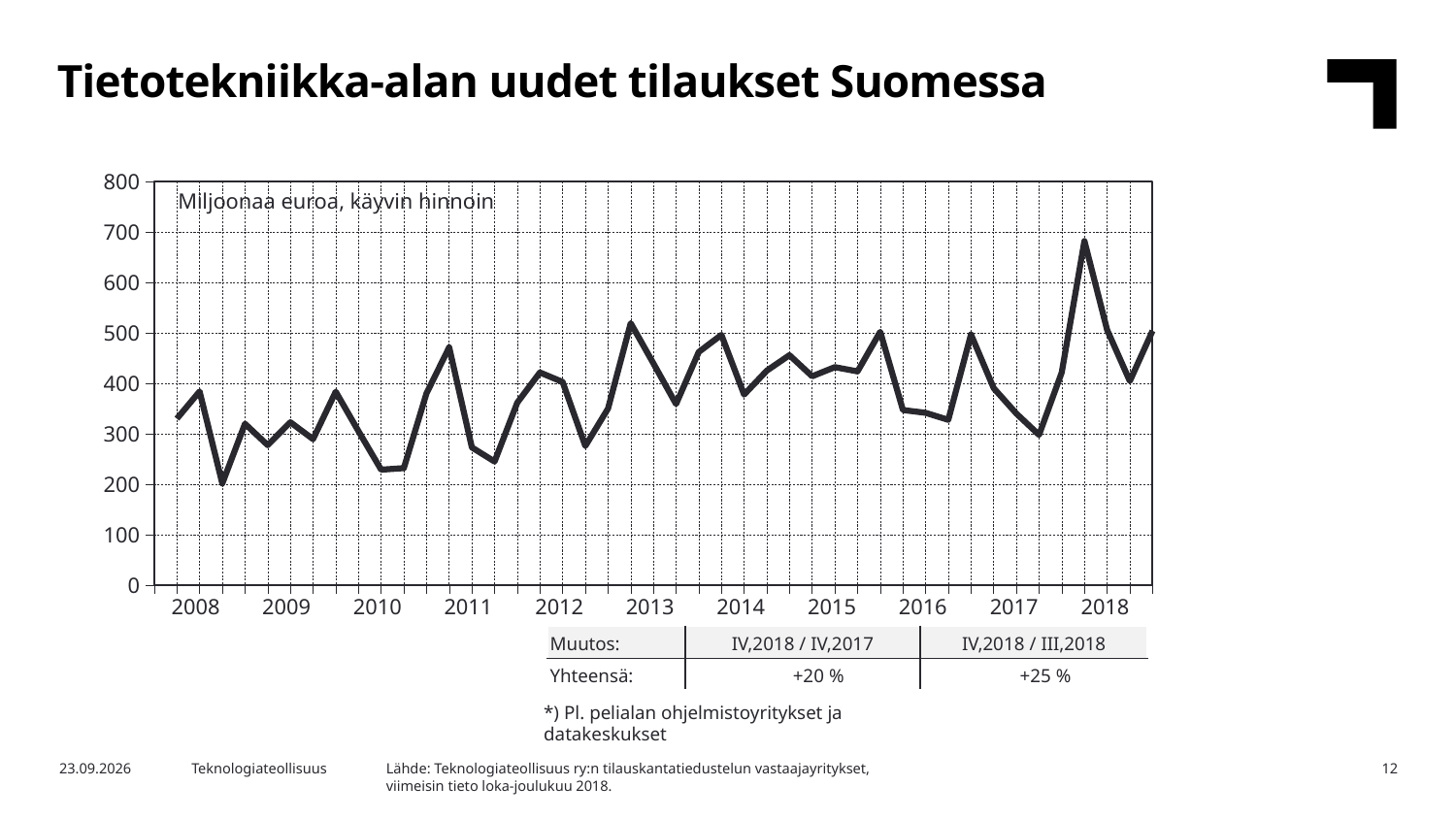
In which year does the line reach its highest point? 2018 In which year does the line reach its lowest point? 2008 How many lines are plotted in the chart? 1 What kind of chart is shown on the slide? line chart Which is higher, the peak of the line in 2017 or the peak in 2013? 2013 Is the highest point of the line greater or less than 600? greater Is the lowest point of the line in 2008 greater or less than 300? less What unit is stated inside the chart area? Miljoonaa euroa, käyvin hinnoin Is the last plotted value in 2018 greater or less than 400? greater How many year labels are shown on the x axis? 11 Between the low point in 2017 and the peak later in 2017, does the line rise or fall? rise What is the title of the chart on the slide? Tietotekniikka-alan uudet tilaukset Suomessa